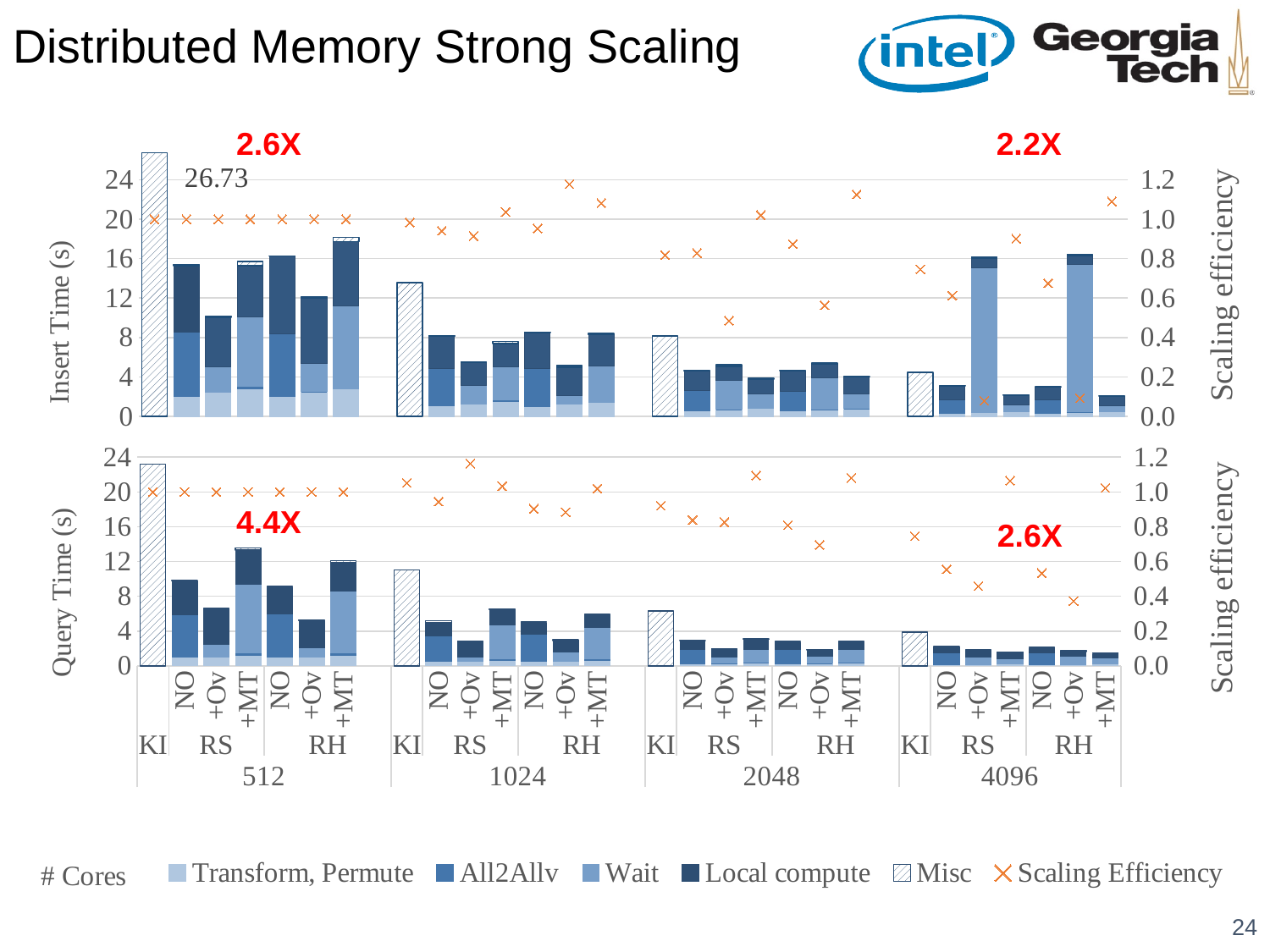
In the Insert Time chart, is the value for RS +Ov at 4096 cores greater or less than 12? greater In the Insert Time chart, do the KI bars rise or fall as the number of cores increases from 512 to 4096? fall In the Query Time chart, is the value for KI at 1024 cores greater or less than 8? greater What kind of chart is the Insert Time chart on the slide? combination chart: stacked bar chart with scaling efficiency markers How many series does the legend at the bottom of the slide list? 6 In the Insert Time chart, what is the value printed for the KI bar at 512 cores? 26.73 How many core-count groups (# Cores) are shown along the x axis of the Query Time chart? 4 In the Query Time chart at 512 cores, which is larger: the RS +MT bar or the RS +Ov bar? RS +MT What speedup annotation is printed above the 512 cores group in the Query Time chart? 4.4X What speedup annotation is printed above the 4096 cores group in the Insert Time chart? 2.2X In the Insert Time chart, is the value for KI at 1024 cores greater or less than 12? greater In the Insert Time chart, which bar is the tallest within the 512 cores group? KI